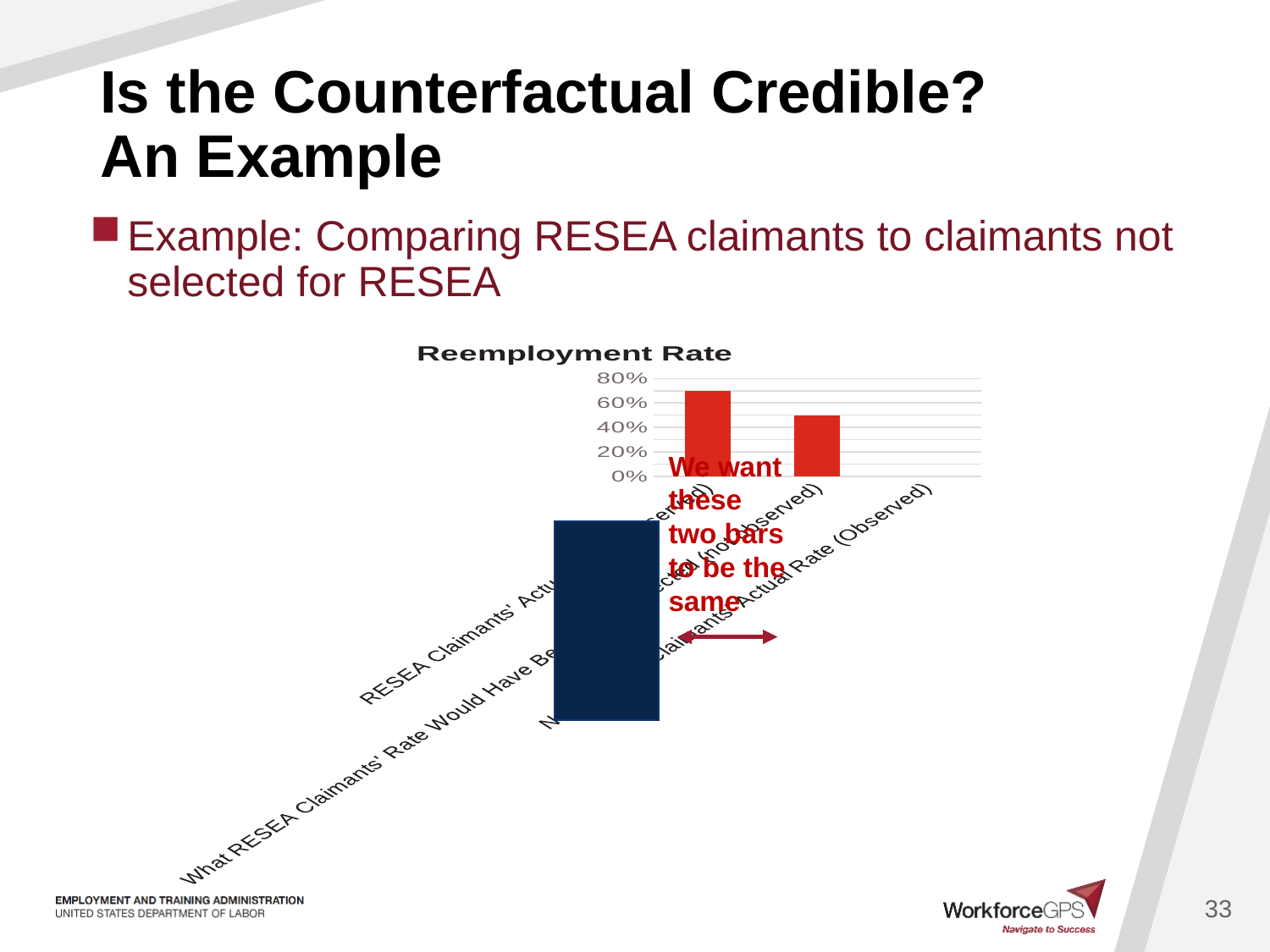
What type of chart is shown on the slide? bar chart Is the value of the left bar greater or less than 80%? less How many red bars are visible in the chart? 2 Is the value of the right bar greater or less than 60%? less Is the value of the left bar greater or less than 60%? greater Do the bar values rise or fall from left to right? fall What is the title of the chart? Reemployment Rate What is the highest value shown on the chart's vertical axis? 80% Which of the two visible bars is taller, the left bar or the right bar? the left bar